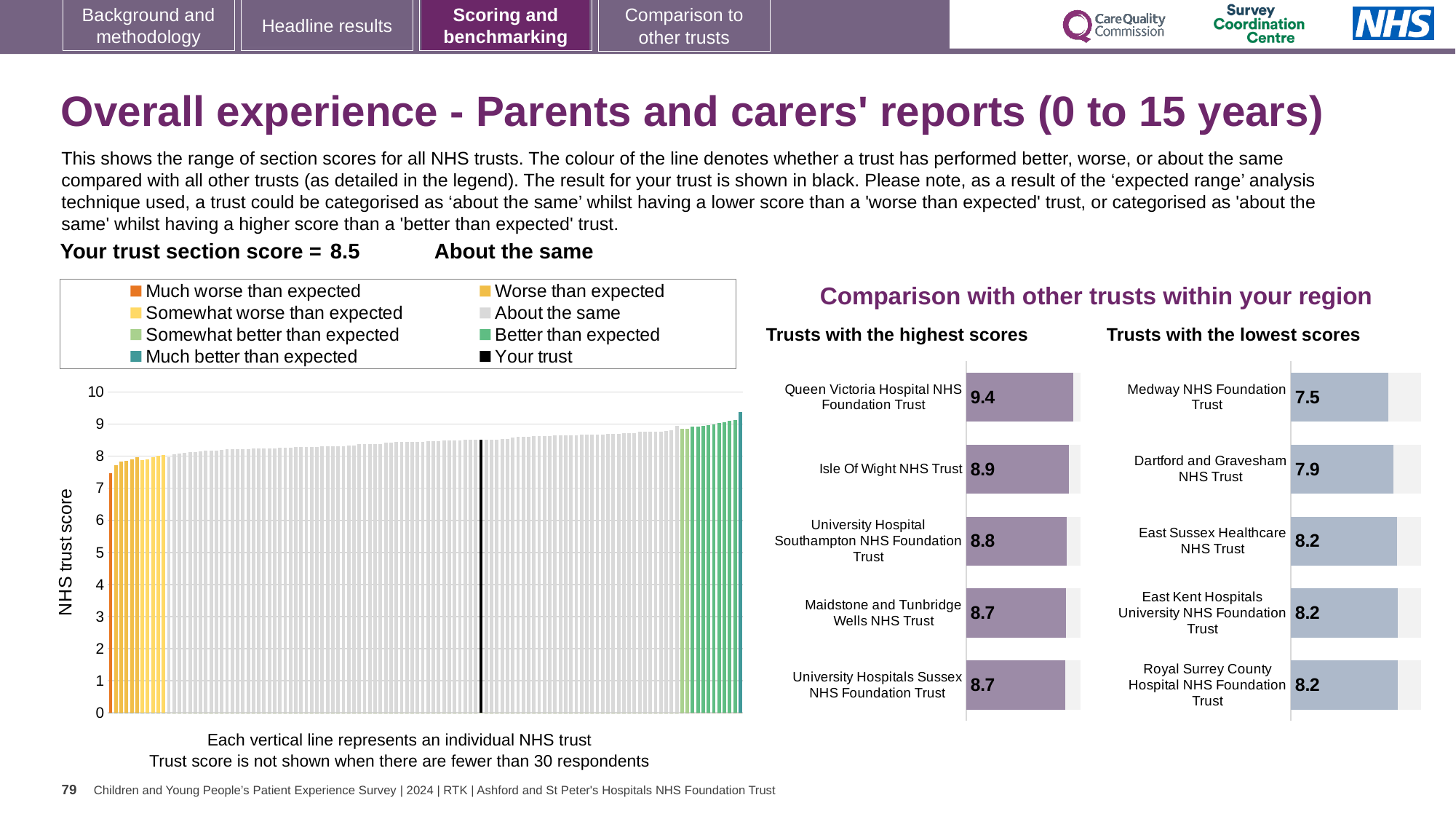
In the 'Trusts with the lowest scores' chart, which trust has the lowest score? Medway NHS Foundation Trust In the 'Trusts with the highest scores' chart, what is the difference between the scores of Queen Victoria Hospital NHS Foundation Trust and Isle Of Wight NHS Trust? 0.5 In the 'Trusts with the lowest scores' chart, what is the difference between the scores of Dartford and Gravesham NHS Trust and Medway NHS Foundation Trust? 0.4 In the 'Trusts with the highest scores' chart, which trust has the highest score? Queen Victoria Hospital NHS Foundation Trust In the 'Trusts with the highest scores' chart, what is the score for Queen Victoria Hospital NHS Foundation Trust? 9.4 In the large chart on the left showing the range of section scores, do the trust scores rise or fall from left to right? rise Which is larger: the score for Isle Of Wight NHS Trust in the 'Trusts with the highest scores' chart or the score for East Sussex Healthcare NHS Trust in the 'Trusts with the lowest scores' chart? Isle Of Wight NHS Trust What type of chart is the large chart on the left showing the range of section scores for all NHS trusts? bar chart In the 'Trusts with the lowest scores' chart, what is the score for Medway NHS Foundation Trust? 7.5 In the 'Trusts with the lowest scores' chart, what is the score for Dartford and Gravesham NHS Trust? 7.9 How many trusts are shown in the 'Trusts with the lowest scores' chart? 5 In the 'Trusts with the highest scores' chart, what is the score for University Hospital Southampton NHS Foundation Trust? 8.8